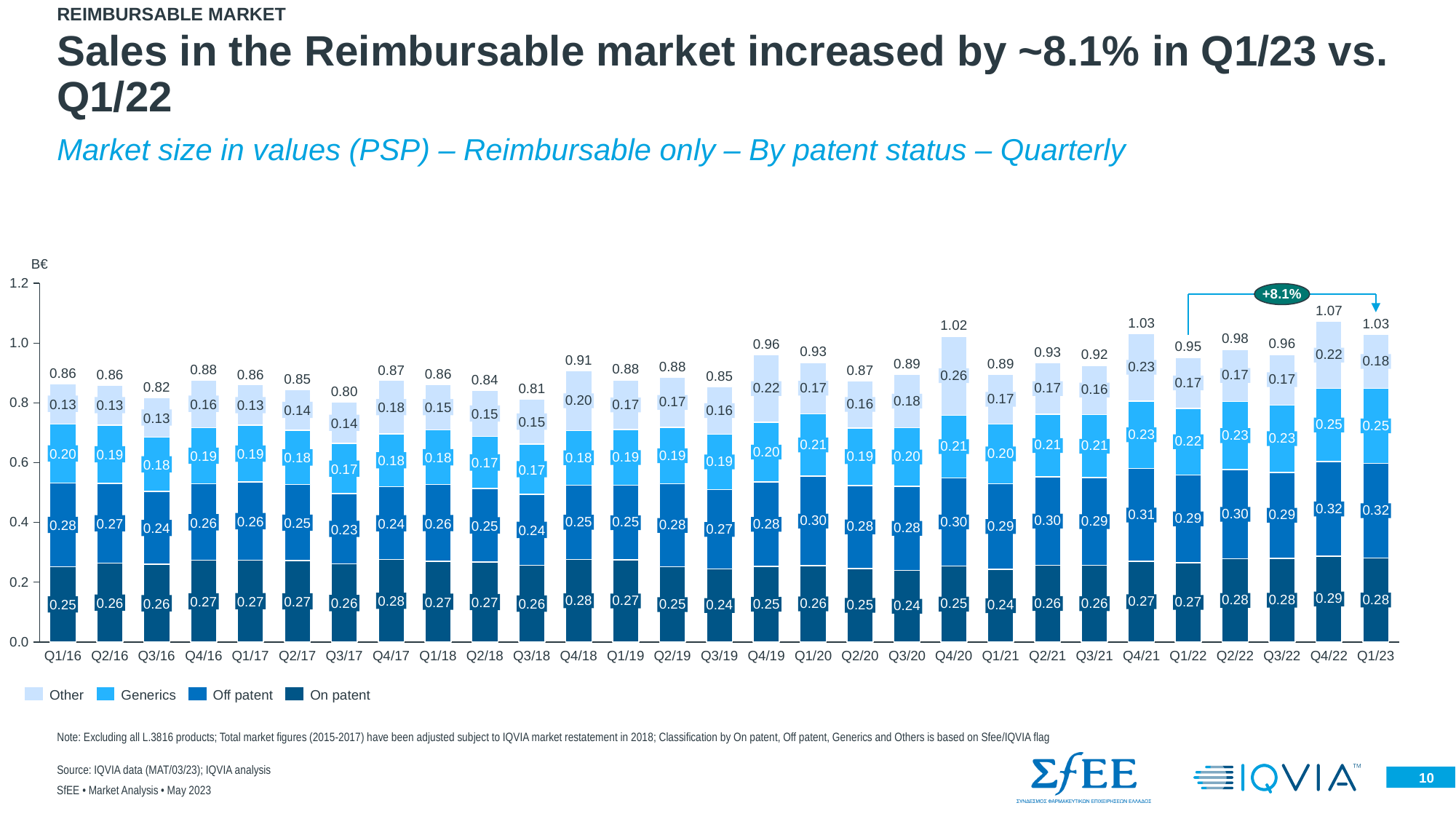
What is the total market value for Q1/23? 1.03 What is the difference between the total for Q1/23 and the total for Q1/22? 0.08 Is the total for Q4/22 greater or less than 1.0? greater What is the Other value for Q4/20? 0.26 How many quarters are plotted on the x axis? 29 How many series does the legend list? 4 Which quarter has the highest total market value? Q4/22 Which quarter has the lowest total market value? Q3/17 What type of chart is shown on the slide? Stacked bar chart Which is larger, the Generics value for Q1/22 or the Generics value for Q1/23? Q1/23 What percentage change is shown in the callout between Q1/22 and Q1/23? +8.1% What is the Off patent value for Q1/23? 0.32